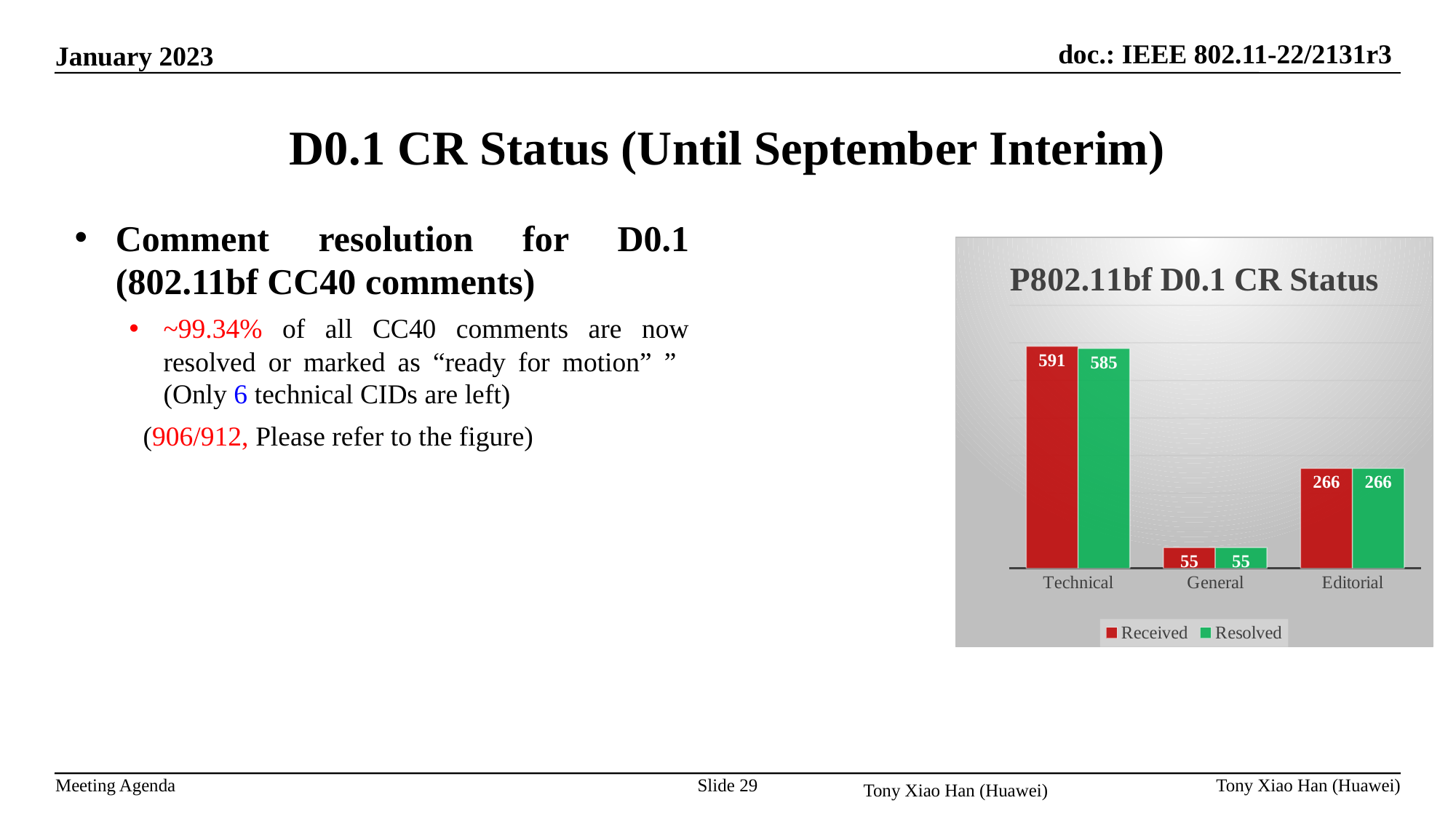
What is the Resolved value for Technical? 585 Which category has the lowest Resolved value? General What is the title of the chart? P802.11bf D0.1 CR Status How many series does the legend list? 2 What is the Received value for General? 55 Which category has the highest Received value? Technical Which is larger, the Received value for Editorial or the Received value for General? Editorial How many categories are shown on the x axis? 3 What is the Resolved value for Editorial? 266 What is the difference between Received and Resolved for Technical? 6 What kind of chart is shown? Bar chart What is the Received value for Technical? 591